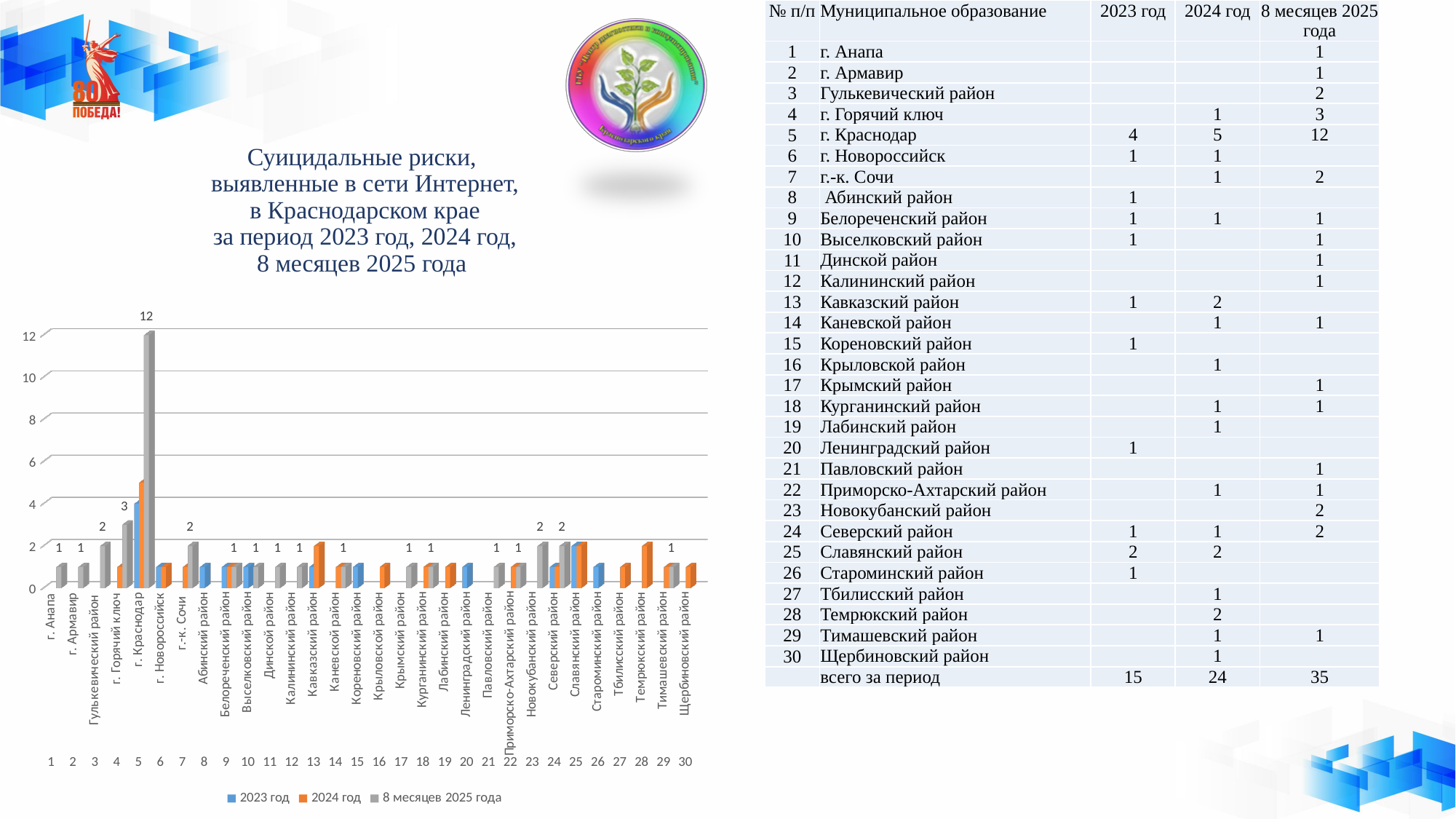
Is the value for г. Краснодар in the series 8 месяцев 2025 года greater or less than 10? greater What kind of chart is shown on the slide? bar chart Which municipality has the highest value in the series 8 месяцев 2025 года? г. Краснодар What is the value for Гулькевический район in the series 8 месяцев 2025 года? 2 How many series does the chart legend list? 3 What is the difference between the 8 месяцев 2025 года values for г. Краснодар and г. Горячий ключ? 9 What is the value for г. Горячий ключ in the series 8 месяцев 2025 года? 3 What is the value for г. Краснодар in the series 2023 год? 4 What is the value for г. Краснодар in the series 8 месяцев 2025 года? 12 How many municipalities (categories) are plotted along the x axis of the chart? 30 Which is larger in the series 8 месяцев 2025 года: г. Краснодар or г.-к. Сочи? г. Краснодар What are the three entries in the chart legend? 2023 год, 2024 год, 8 месяцев 2025 года